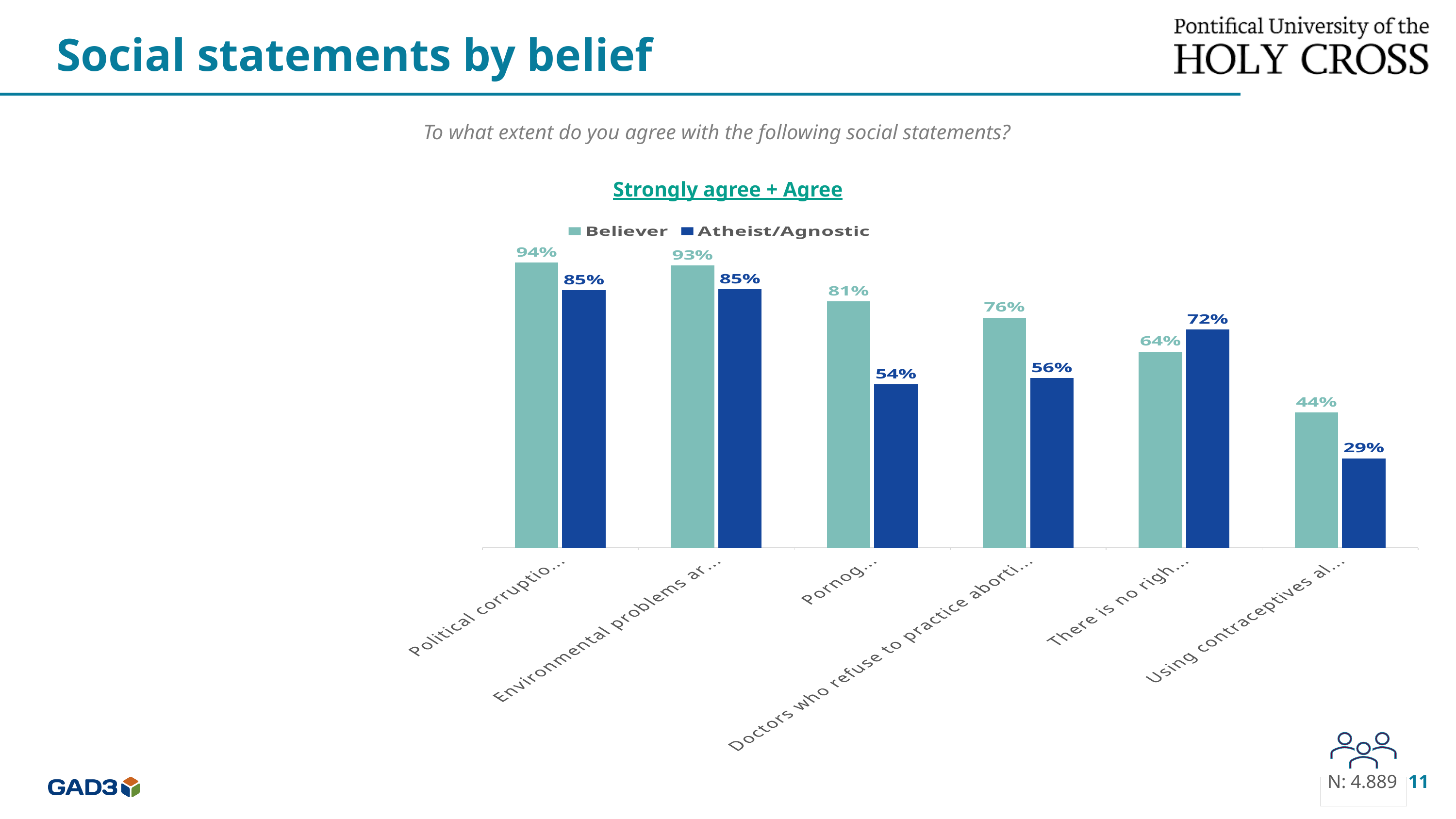
What is the Atheist/Agnostic value for the category labelled "Pornog..."? 54% What is the Believer value for the category labelled "Using contraceptives al..."? 44% What is the difference between the Believer and Atheist/Agnostic values for the category labelled "Pornog..."? 27 percentage points How many series does the chart legend list? 2 How many categories are shown on the x axis of the chart? 6 Which category has the lowest Atheist/Agnostic value? Using contraceptives al... (the last category) What is the difference between the Believer and Atheist/Agnostic values for the category labelled "Doctors who refuse to practice aborti..."? 20 percentage points For the category labelled "There is no righ...", which series has the larger value, Believer or Atheist/Agnostic? Atheist/Agnostic What kind of chart is shown on the slide? Bar chart Which category has the highest Believer value? Political corruptio... (the first category) What is the Believer value for the first category, labelled "Political corruptio..."? 94% What is the Atheist/Agnostic value for the category labelled "There is no righ..."? 72%